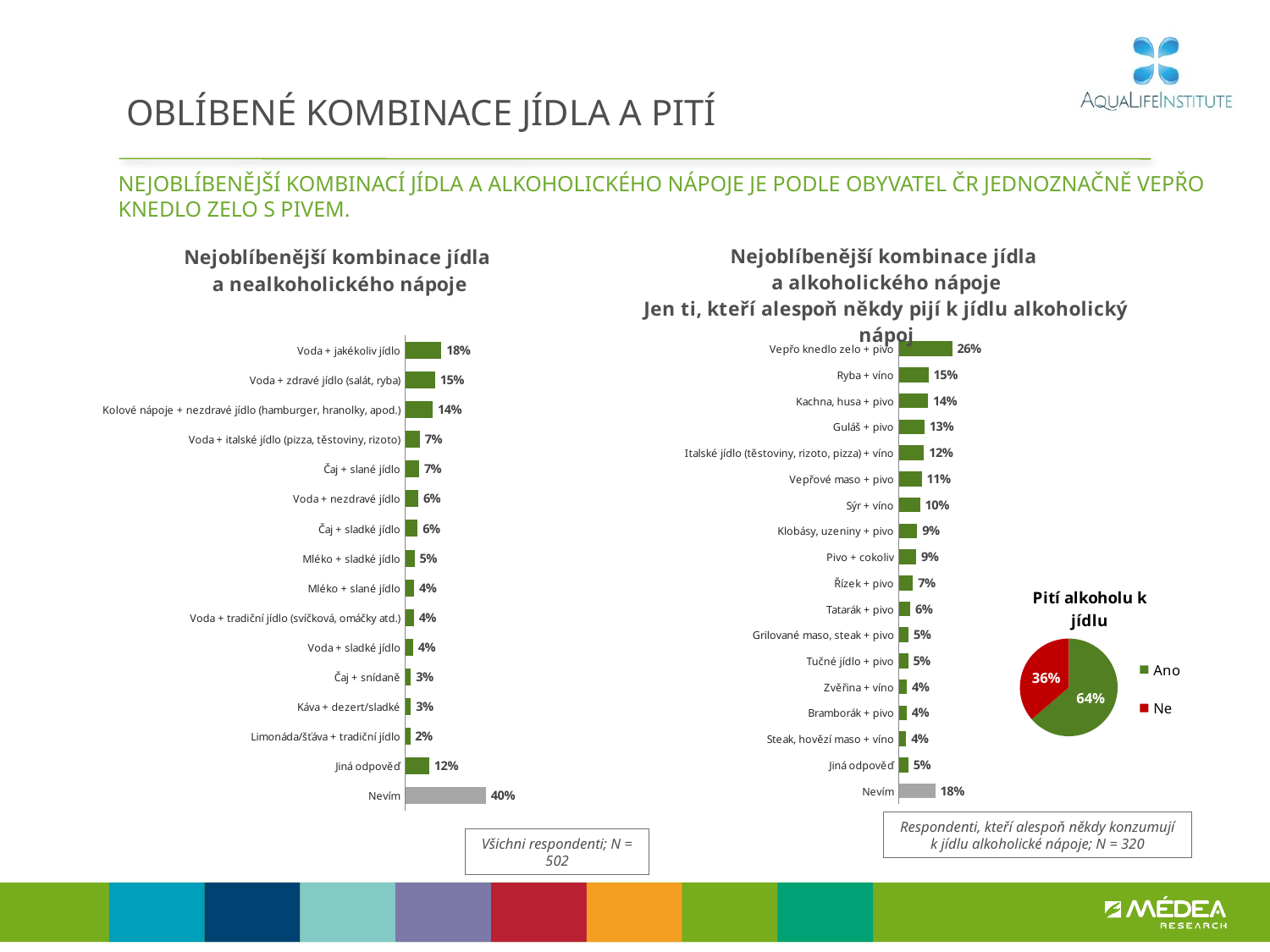
How many categories are shown in the chart 'Nejoblíbenější kombinace jídla a nealkoholického nápoje'? 16 In the chart 'Nejoblíbenější kombinace jídla a nealkoholického nápoje', what is the difference between 'Voda + zdravé jídlo (salát, ryba)' and 'Kolové nápoje + nezdravé jídlo (hamburger, hranolky, apod.)'? 1% In the chart 'Nejoblíbenější kombinace jídla a alkoholického nápoje', what is the value for 'Sýr + víno'? 10% In the chart 'Nejoblíbenější kombinace jídla a alkoholického nápoje', which is larger: 'Ryba + víno' or 'Guláš + pivo'? Ryba + víno What type of chart is 'Pití alkoholu k jídlu'? Pie chart In the chart 'Nejoblíbenější kombinace jídla a nealkoholického nápoje', what is the value for 'Nevím'? 40% In the chart 'Nejoblíbenější kombinace jídla a nealkoholického nápoje', which category has the lowest value? Limonáda/šťáva + tradiční jídlo In the chart 'Nejoblíbenější kombinace jídla a nealkoholického nápoje', what is the value for 'Voda + jakékoliv jídlo'? 18% In the pie chart 'Pití alkoholu k jídlu', what share does 'Ano' have? 64% In the chart 'Nejoblíbenější kombinace jídla a alkoholického nápoje', which category has the highest value? Vepřo knedlo zelo + pivo How many categories are shown in the chart 'Nejoblíbenější kombinace jídla a alkoholického nápoje'? 18 In the chart 'Nejoblíbenější kombinace jídla a alkoholického nápoje', what is the difference between 'Vepřo knedlo zelo + pivo' and 'Nevím'? 8%